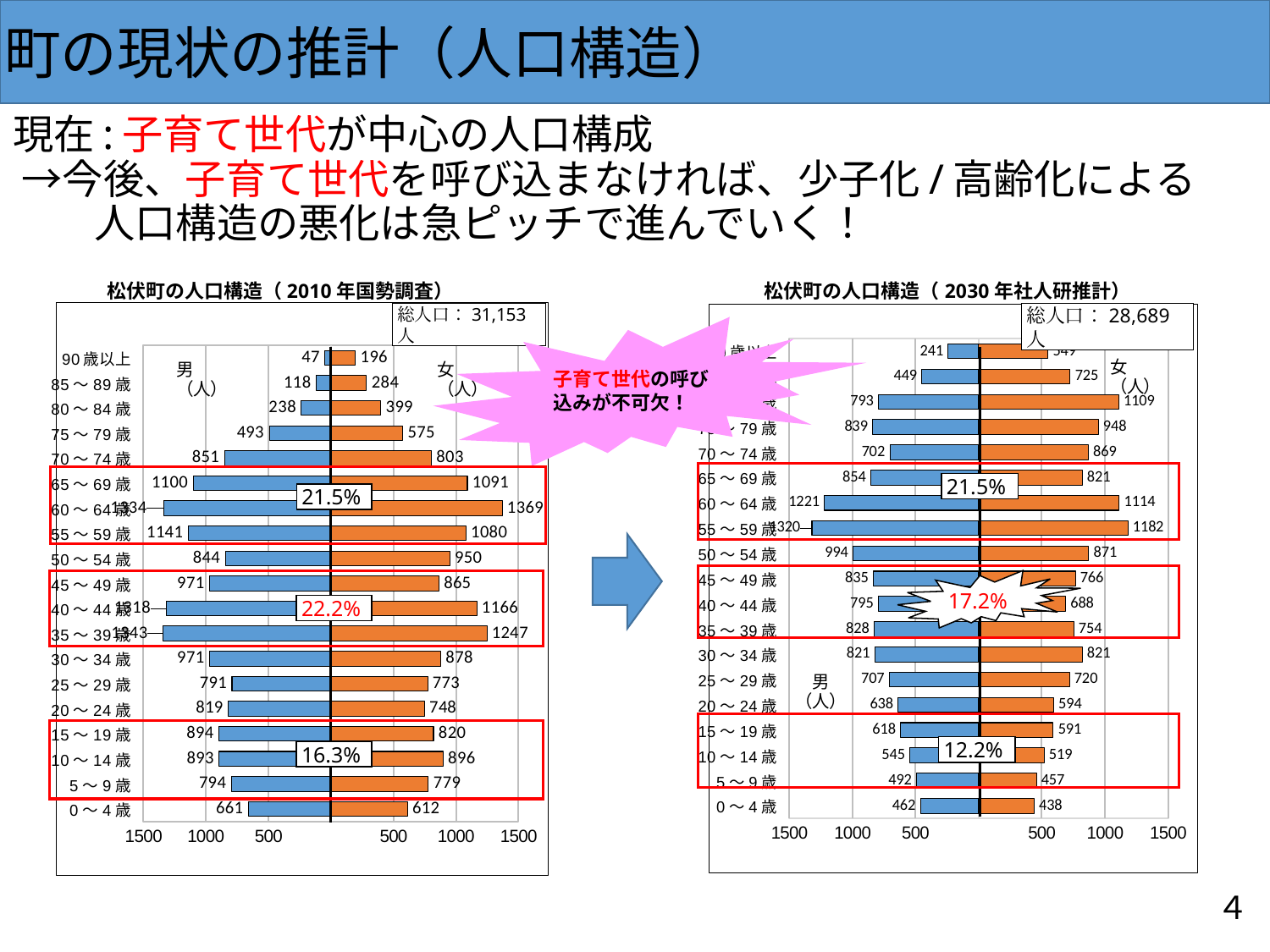
In the right chart (2030年社人研推計), which is larger for the 20～24歳 group, 男 or 女? 男 What total population (総人口) is shown on the right chart (2030年社人研推計)? 28,689人 In the left chart (松伏町の人口構造 2010年国勢調査), what is the value for 女 in the 65～69歳 group? 1091 In the left chart (2010年国勢調査), which age group has the lowest value for 男? 90歳以上 In the right chart (2030年社人研推計), what is the difference between 男 and 女 in the 85～89歳 group? 276 How many age groups are shown in the right chart (2030年社人研推計)? 19 In the left chart (2010年国勢調査), what is the difference between 男 and 女 in the 90歳以上 group? 149 What kind of chart is the left chart (松伏町の人口構造 2010年国勢調査)? Bar chart (population pyramid) In the left chart (松伏町の人口構造 2010年国勢調査), what is the value for 男 in the 0～4歳 group? 661 In the left chart (2010年国勢調査), which is larger for the 50～54歳 group, 男 or 女? 女 In the right chart (松伏町の人口構造 2030年社人研推計), what is the value for 男 in the 60～64歳 group? 1221 In the right chart (松伏町の人口構造 2030年社人研推計), what is the value for 女 in the 80～84歳 group? 1109